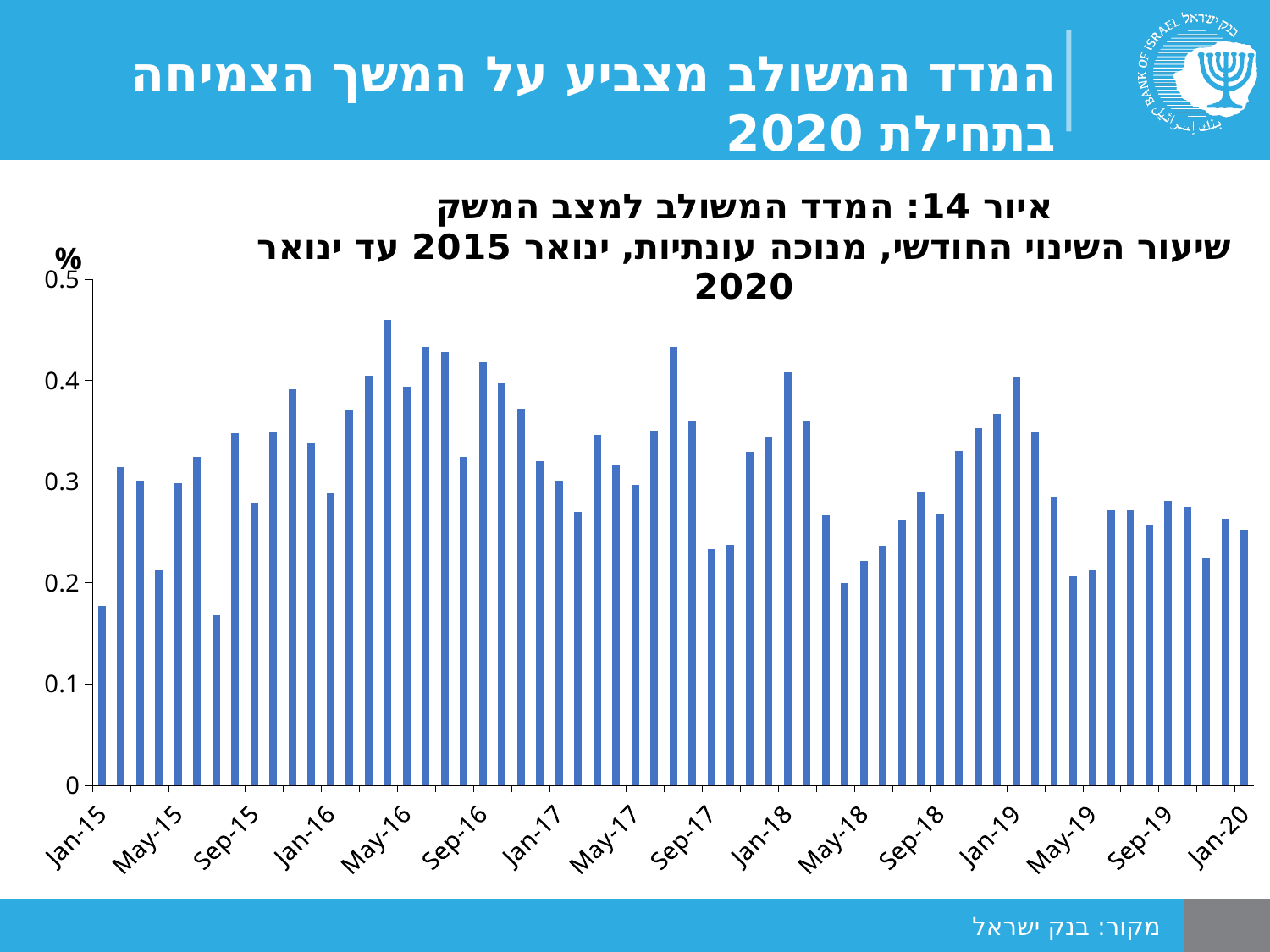
Is the value for Jan-18 greater or less than 0.3? greater Is the value for Sep-17 greater or less than 0.3? less Which is larger, the value for Sep-16 or the value for Sep-17? Sep-16 Is the value for Jan-15 greater or less than 0.2? less What kind of chart is shown on the slide? bar chart How many month labels are shown on the x axis? 16 Which is larger, the value for Jan-18 or the value for May-18? Jan-18 What is the highest value shown on the y axis? 0.5